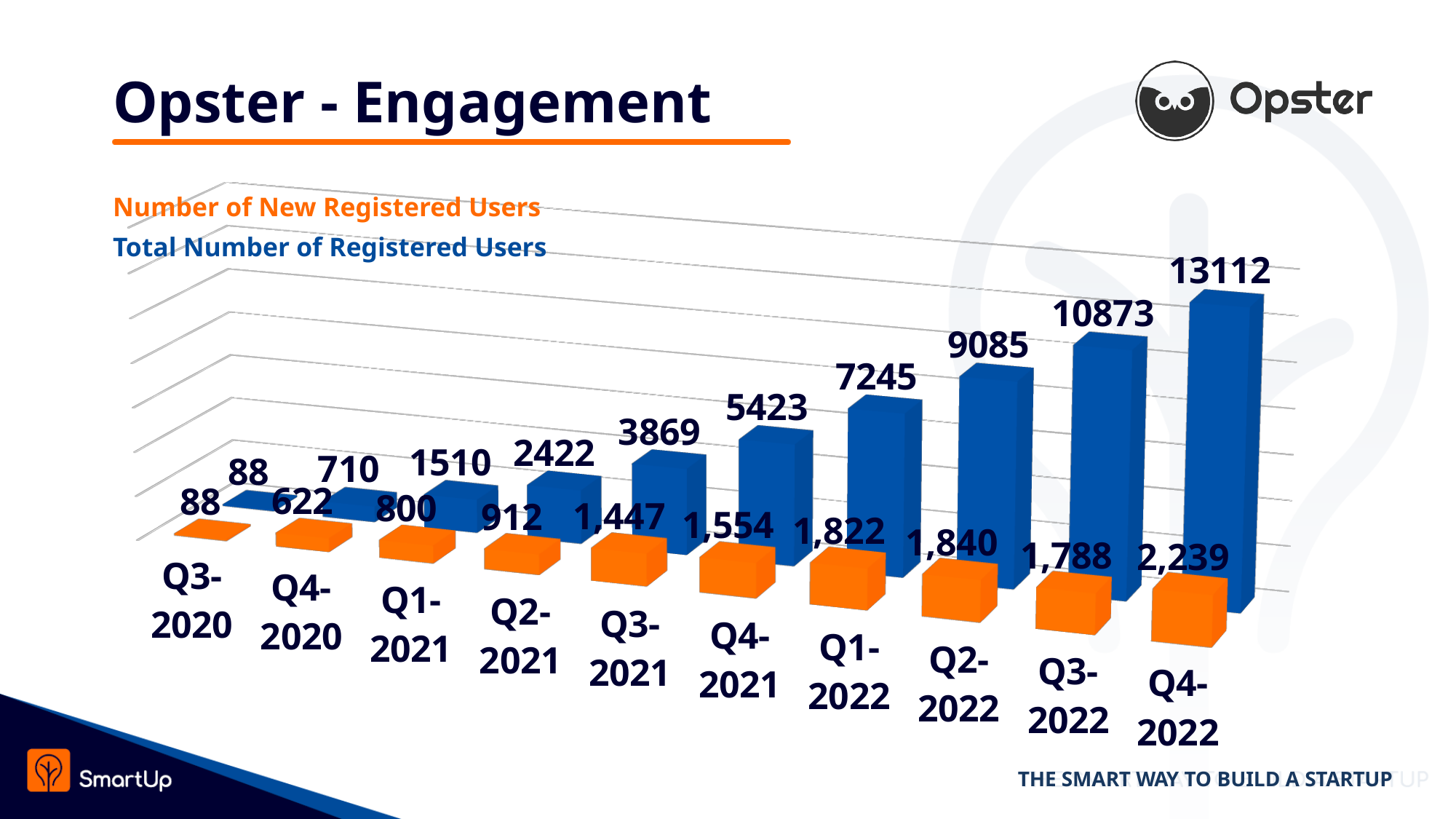
In which quarter is the Total Number of Registered Users lowest? Q3-2020 How many quarters are shown on the x axis? 10 How many series does the chart show? 2 What is the Number of New Registered Users in Q1-2022? 1,822 What is the Total Number of Registered Users in Q4-2022? 13112 What kind of chart is shown on the slide? Bar chart Which is larger: the Number of New Registered Users in Q2-2022 or in Q3-2022? Q2-2022 Does the Total Number of Registered Users rise or fall from Q3-2020 to Q4-2022? Rise In which quarter is the Number of New Registered Users highest? Q4-2022 What is the difference between the Total Number of Registered Users in Q4-2022 and Q3-2022? 2239 What is the Total Number of Registered Users in Q2-2021? 2422 What is the Number of New Registered Users in Q3-2021? 1,447